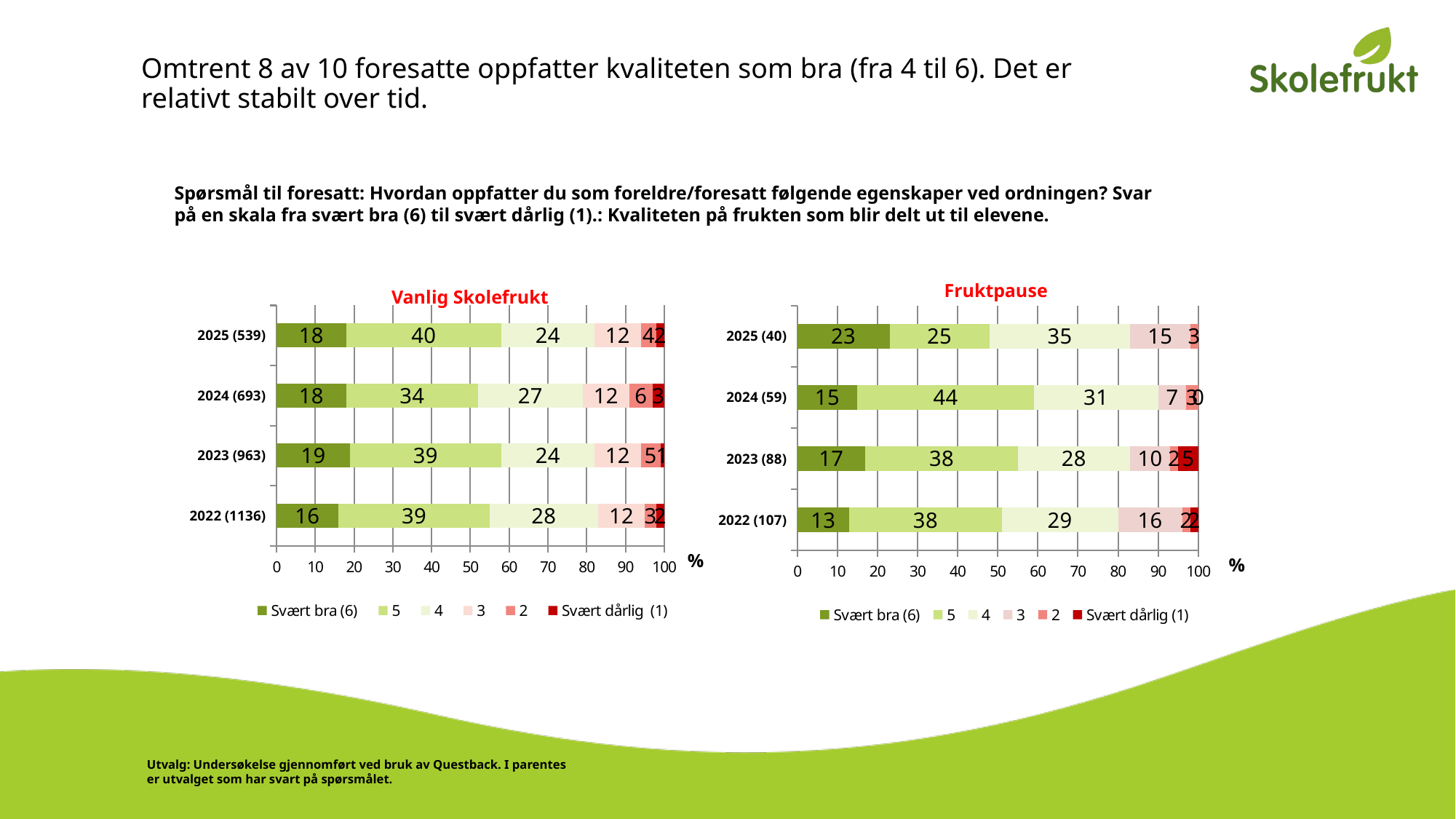
In the "Vanlig Skolefrukt" chart, which year has the highest value for "Svært bra (6)"? 2023 (963) How many years (bars) are shown in the "Vanlig Skolefrukt" chart? 4 In the "Vanlig Skolefrukt" chart, what is the value for "5" in 2025 (539)? 40 In the "Fruktpause" chart, what is the value for "3" in 2022 (107)? 16 In the "Fruktpause" chart, what is the value for "Svært bra (6)" in 2025 (40)? 23 In the "Fruktpause" chart, which year has the lowest value for "Svært bra (6)"? 2022 (107) In the "Vanlig Skolefrukt" chart, what is the value for "4" in 2024 (693)? 27 In the "Fruktpause" chart, what is the difference between the "4" value in 2025 (40) and in 2023 (88)? 7 In the "Fruktpause" chart, what is the value for "5" in 2024 (59)? 44 In the "Vanlig Skolefrukt" chart, is the "5" value larger in 2025 (539) or in 2024 (693)? 2025 (539) How many series does the legend of the "Fruktpause" chart list? 6 What type of chart is the "Vanlig Skolefrukt" chart? Stacked bar chart